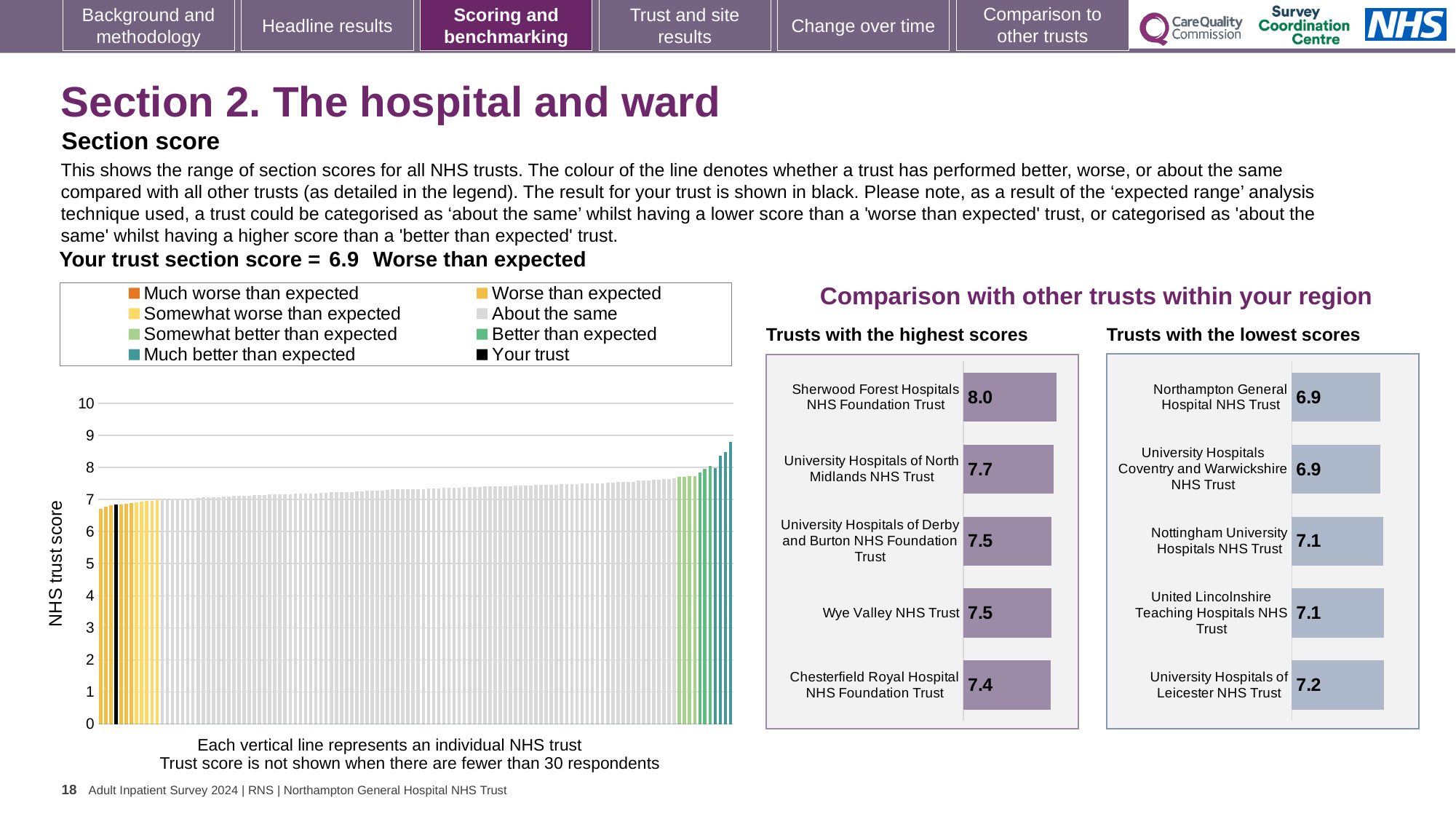
In the 'Trusts with the highest scores' chart, what is the score for Sherwood Forest Hospitals NHS Foundation Trust? 8.0 In the 'Trusts with the highest scores' chart, what is the difference between the scores of Sherwood Forest Hospitals NHS Foundation Trust and Chesterfield Royal Hospital NHS Foundation Trust? 0.6 What is the title of the comparison section on the right of the slide? Comparison with other trusts within your region How many entries does the legend of the large NHS trust score chart on the left list? 8 In the 'Trusts with the highest scores' chart, which has the larger score: University Hospitals of North Midlands NHS Trust or Wye Valley NHS Trust? University Hospitals of North Midlands NHS Trust In the 'Trusts with the highest scores' chart, what is the score for Chesterfield Royal Hospital NHS Foundation Trust? 7.4 What kind of chart is the large NHS trust score chart on the left of the slide? Bar chart In the 'Trusts with the highest scores' chart, which trust has the highest score? Sherwood Forest Hospitals NHS Foundation Trust In the 'Trusts with the lowest scores' chart, which trust has the highest score? University Hospitals of Leicester NHS Trust In the 'Trusts with the lowest scores' chart, what is the score for Nottingham University Hospitals NHS Trust? 7.1 In the large NHS trust score chart on the left, do the trust scores rise or fall from left to right? Rise How many trusts are shown in the 'Trusts with the lowest scores' chart? 5